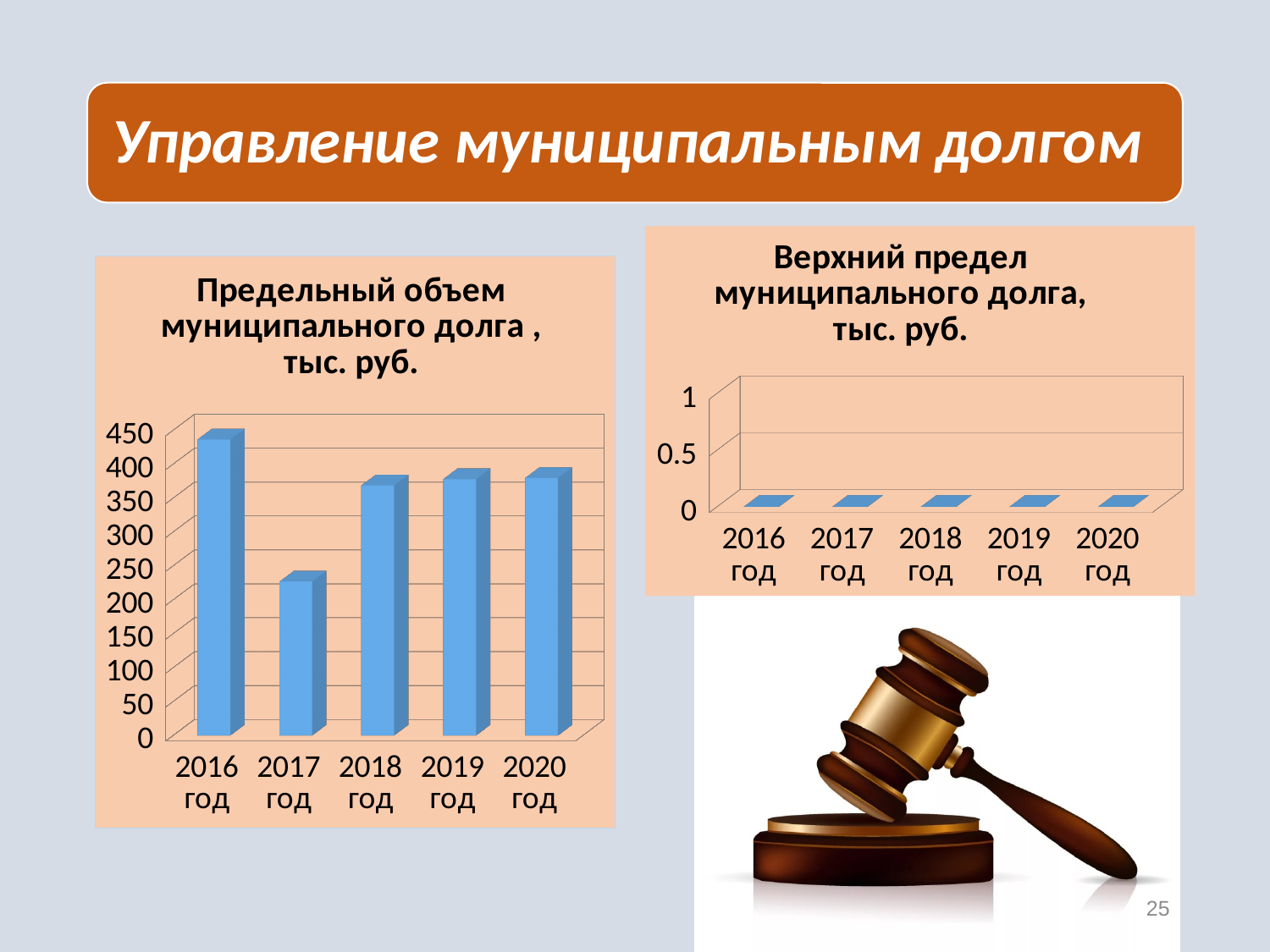
In the right chart "Верхний предел муниципального долга, тыс. руб.", what is the value for 2018 год? 0 In the left chart "Предельный объем муниципального долга", which year has the highest value? 2016 год In the left chart "Предельный объем муниципального долга", which is larger, the value for 2016 год or 2017 год? 2016 год In the left chart "Предельный объем муниципального долга", is the value for 2017 год greater or less than 250? less In the left chart "Предельный объем муниципального долга", does the value rise or fall from 2016 год to 2017 год? fall In the left chart "Предельный объем муниципального долга", is the value for 2018 год greater or less than 300? greater In the left chart "Предельный объем муниципального долга", how many years are shown on the x axis? 5 In the right chart "Верхний предел муниципального долга, тыс. руб.", how many years are shown on the x axis? 5 What is the title of the right chart on the slide? Верхний предел муниципального долга, тыс. руб. What kind of chart is the left chart titled "Предельный объем муниципального долга, тыс. руб."? bar chart In the left chart "Предельный объем муниципального долга", which year has the lowest value? 2017 год In the left chart "Предельный объем муниципального долга", is the value for 2016 год greater or less than 400? greater